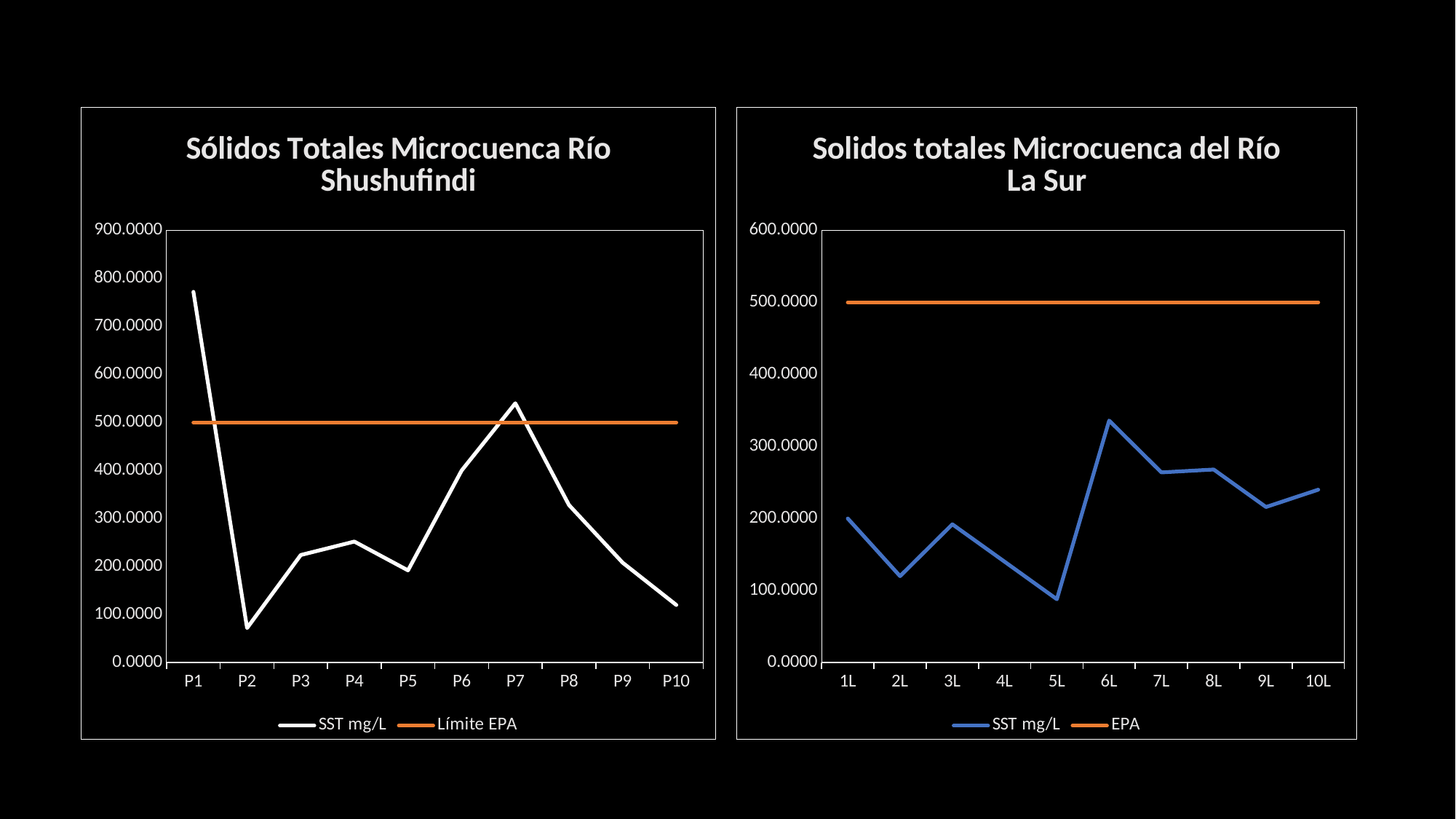
How many points are plotted along the x axis of the 'Sólidos Totales Microcuenca Río Shushufindi' chart? 10 In the 'Solidos totales Microcuenca del Río La Sur' chart, which is larger, the SST mg/L value for 1L or for 6L? 6L In the 'Sólidos Totales Microcuenca Río Shushufindi' chart, is the SST mg/L value for P2 greater or less than 100.0000? less What is the name of the orange series in the legend of the 'Sólidos Totales Microcuenca Río Shushufindi' chart? Límite EPA How many series does the legend of the 'Solidos totales Microcuenca del Río La Sur' chart list? 2 What kind of chart is the 'Sólidos Totales Microcuenca Río Shushufindi' chart? line chart In the 'Sólidos Totales Microcuenca Río Shushufindi' chart, is the SST mg/L value for P1 greater or less than 700.0000? greater In the 'Solidos totales Microcuenca del Río La Sur' chart, is the SST mg/L value for 6L greater or less than 300.0000? greater In the 'Solidos totales Microcuenca del Río La Sur' chart, which point has the lowest SST mg/L value? 5L In the 'Sólidos Totales Microcuenca Río Shushufindi' chart, which point has the highest SST mg/L value? P1 In the 'Solidos totales Microcuenca del Río La Sur' chart, which point has the highest SST mg/L value? 6L In the 'Sólidos Totales Microcuenca Río Shushufindi' chart, which point has the lowest SST mg/L value? P2